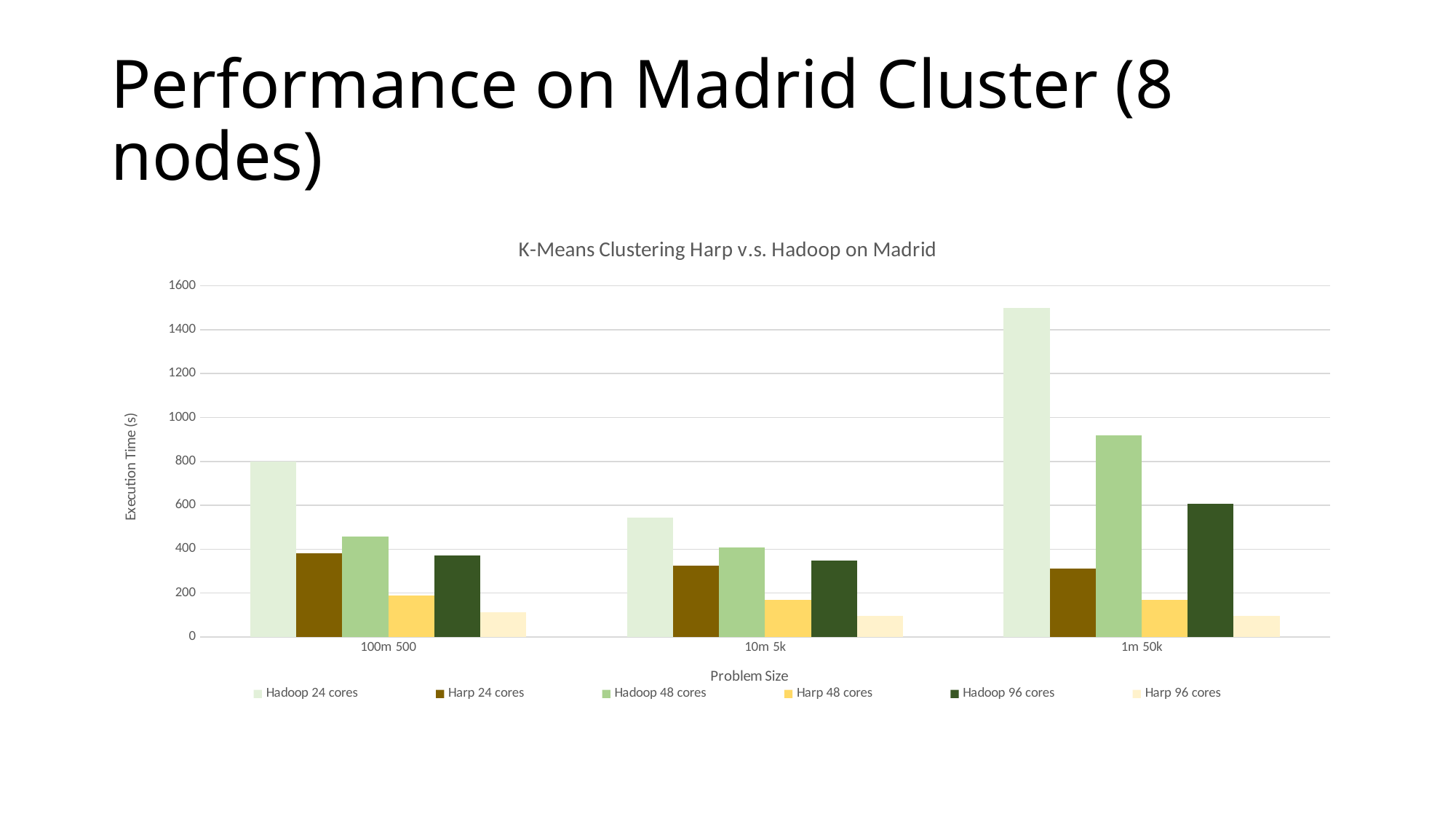
What kind of chart is shown on the slide? bar chart At 1m 50k, which is larger: Hadoop 48 cores or Hadoop 96 cores? Hadoop 48 cores What is the title of the chart? K-Means Clustering Harp v.s. Hadoop on Madrid Is the value for Hadoop 24 cores at 1m 50k greater or less than 1400? greater At 10m 5k, which is larger: Hadoop 48 cores or Harp 48 cores? Hadoop 48 cores For which problem size is the Hadoop 24 cores bar the highest? 1m 50k How many problem sizes are shown on the x axis? 3 Which series has the lowest bar at 1m 50k? Harp 96 cores How many series does the legend list? 6 What is the label of the y axis? Execution Time (s) Is the value for Harp 48 cores at 100m 500 greater or less than 200? less Is the value for Hadoop 96 cores at 1m 50k greater or less than 400? greater